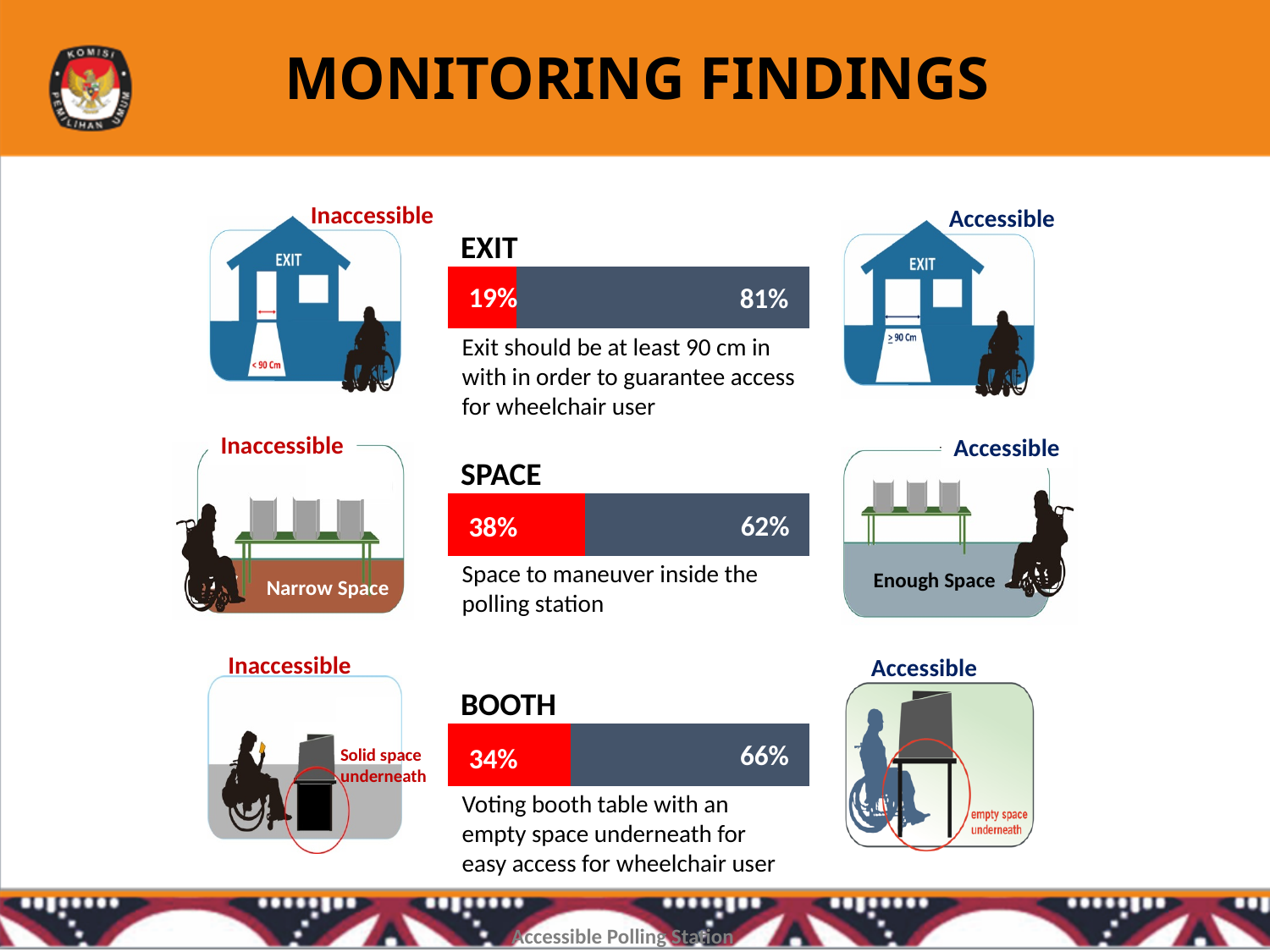
In the EXIT bar, what percentage is shown in the red segment? 19% How many stacked bars are shown on the slide? 3 Which of the three bars (EXIT, SPACE, BOOTH) has the smallest red segment? EXIT Which of the three bars (EXIT, SPACE, BOOTH) has the largest red segment? SPACE What is the title of the slide containing the bars? MONITORING FINDINGS In the BOOTH bar, what percentage is shown in the dark segment? 66% What is the total of the two segments in the BOOTH bar? 100% In the EXIT bar, what percentage is shown in the dark segment? 81% What is the difference between the dark segment of the EXIT bar and the dark segment of the SPACE bar? 19% In the SPACE bar, what percentage is shown in the red segment? 38% Is the red segment of the SPACE bar larger or smaller than the red segment of the BOOTH bar? larger What kind of chart is used to show the EXIT, SPACE and BOOTH findings? Stacked bar chart